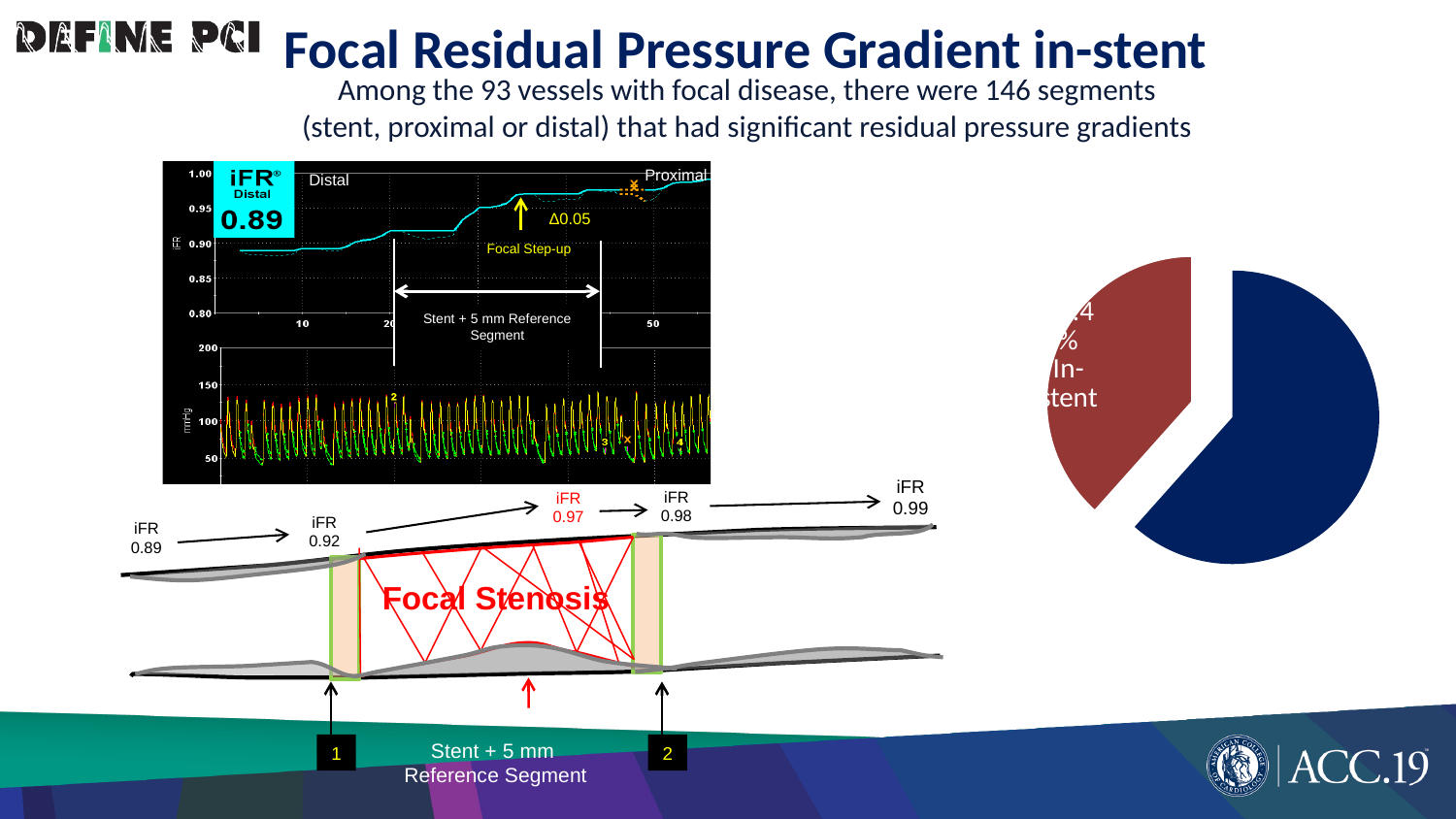
In the pie chart on the right, what colour is the slice that is pulled out from the rest of the pie? dark red In the pie chart on the right, is the In-stent slice the larger or the smaller of the two slices? the smaller What kind of chart is shown on the right side of the slide? pie chart In the pie chart on the right, which slice is larger, the dark blue slice or the dark red slice? the dark blue slice In the iFR pullback trace on the left, what iFR Distal value is shown in the box? 0.89 How many slices does the pie chart on the right have? 2 In the iFR pullback trace on the left, what is the highest tick value shown on the iFR y-axis? 1.00 In the iFR pullback trace on the left, what delta value is labelled next to the yellow arrow for the focal step-up? Δ0.05 In the pie chart on the right, what colour is the largest slice? dark blue In the pie chart on the right, does the In-stent slice cover more or less than half of the pie? less